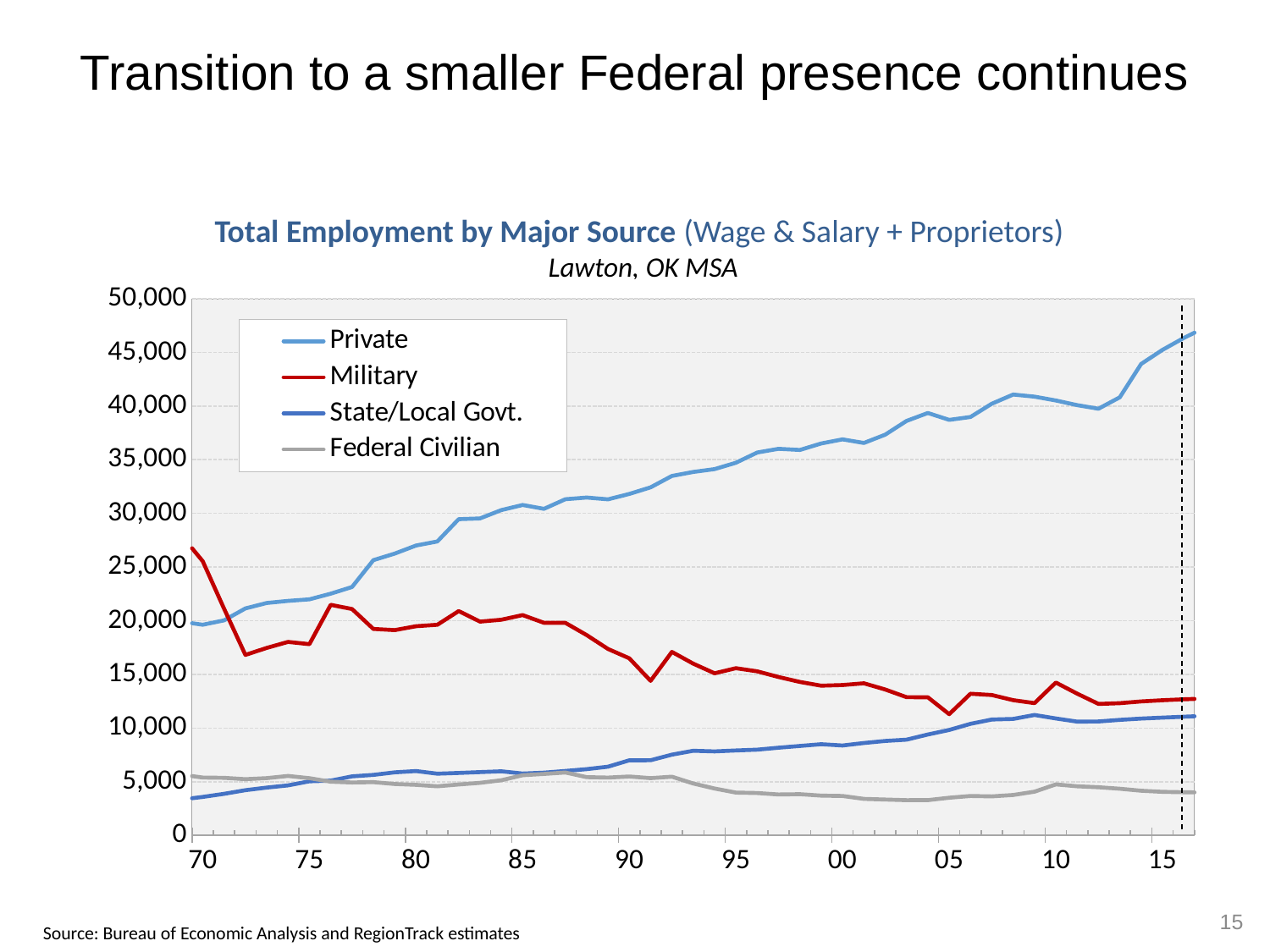
Does the Private series rise or fall overall from 70 to 15? Rise Is the Military value at 70 greater or less than 25,000? greater Which series has the lowest value at 15? Federal Civilian Is the Military value at 15 greater or less than 15,000? less What kind of chart is shown on the slide? Line chart Which series is drawn in red? Military How many series does the legend list? 4 At 00, which is larger, the Private value or the Military value? Private What is the title of the chart? Total Employment by Major Source (Wage & Salary + Proprietors) Which series has the highest value at 15? Private Does the Military series rise or fall overall from 70 to 15? Fall Which series has the highest value at 70? Military